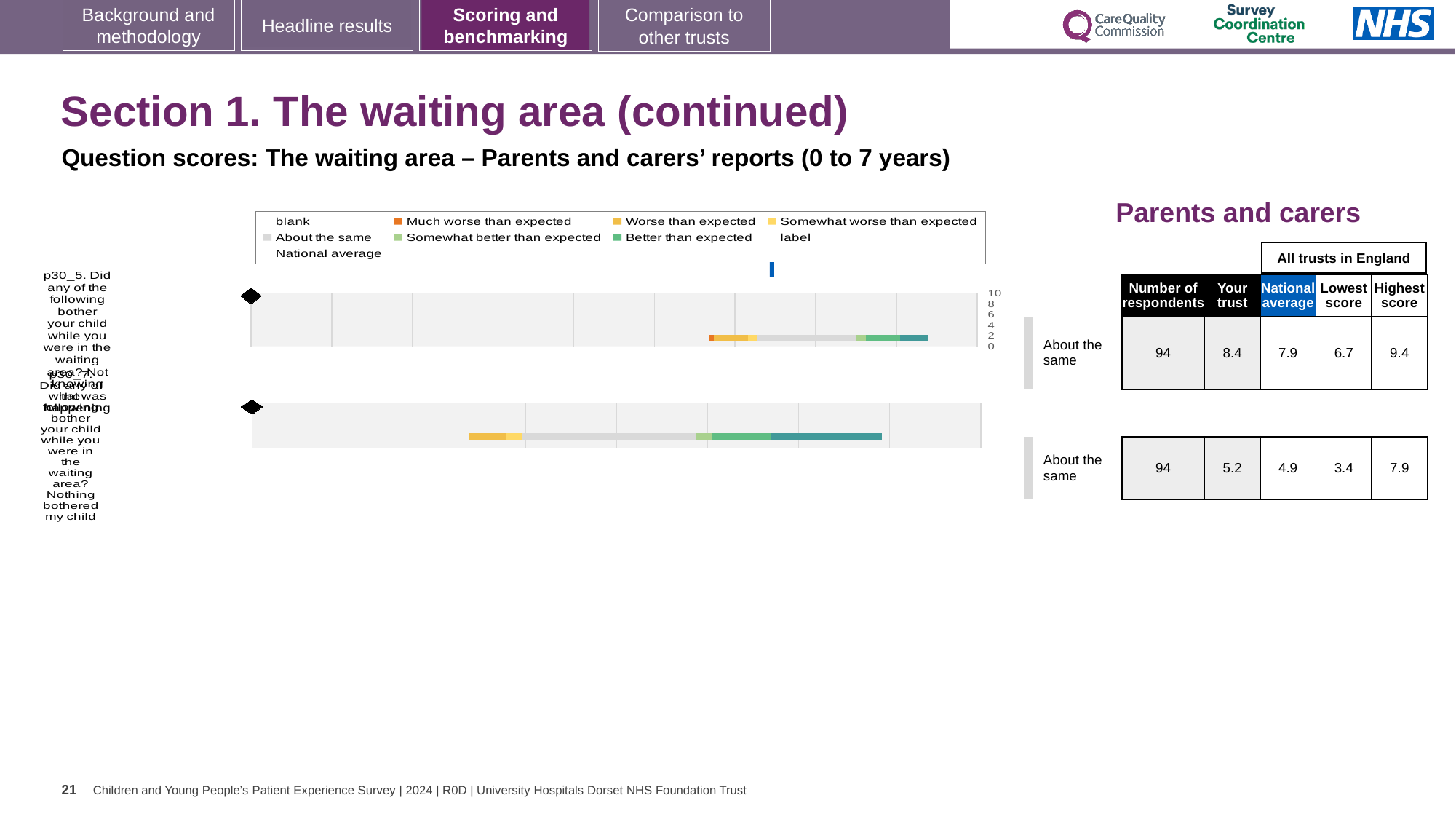
How many entries does the chart legend list? 9 What kind of chart is shown on the slide? bar chart According to the table beside the chart, what is the lowest score among all trusts in England for question p30_7? 3.4 What is the highest tick value shown on the chart's numeric axis? 10 How many question bars are plotted in the chart? 2 According to the table beside the chart, what is the 'Your trust' score for question p30_5 (Not knowing what was happening)? 8.4 How many respondents are listed for each question in the table beside the chart? 94 For question p30_7, what is the difference between the 'Your trust' score (5.2) and the national average (4.9)? 0.3 According to the table beside the chart, what is the highest score among all trusts in England for question p30_5? 9.4 For question p30_5, which is larger: the 'Your trust' score or the national average? Your trust Which legend entry is shown in orange? Much worse than expected According to the table beside the chart, what is the national average score for question p30_7 (Nothing bothered my child)? 4.9